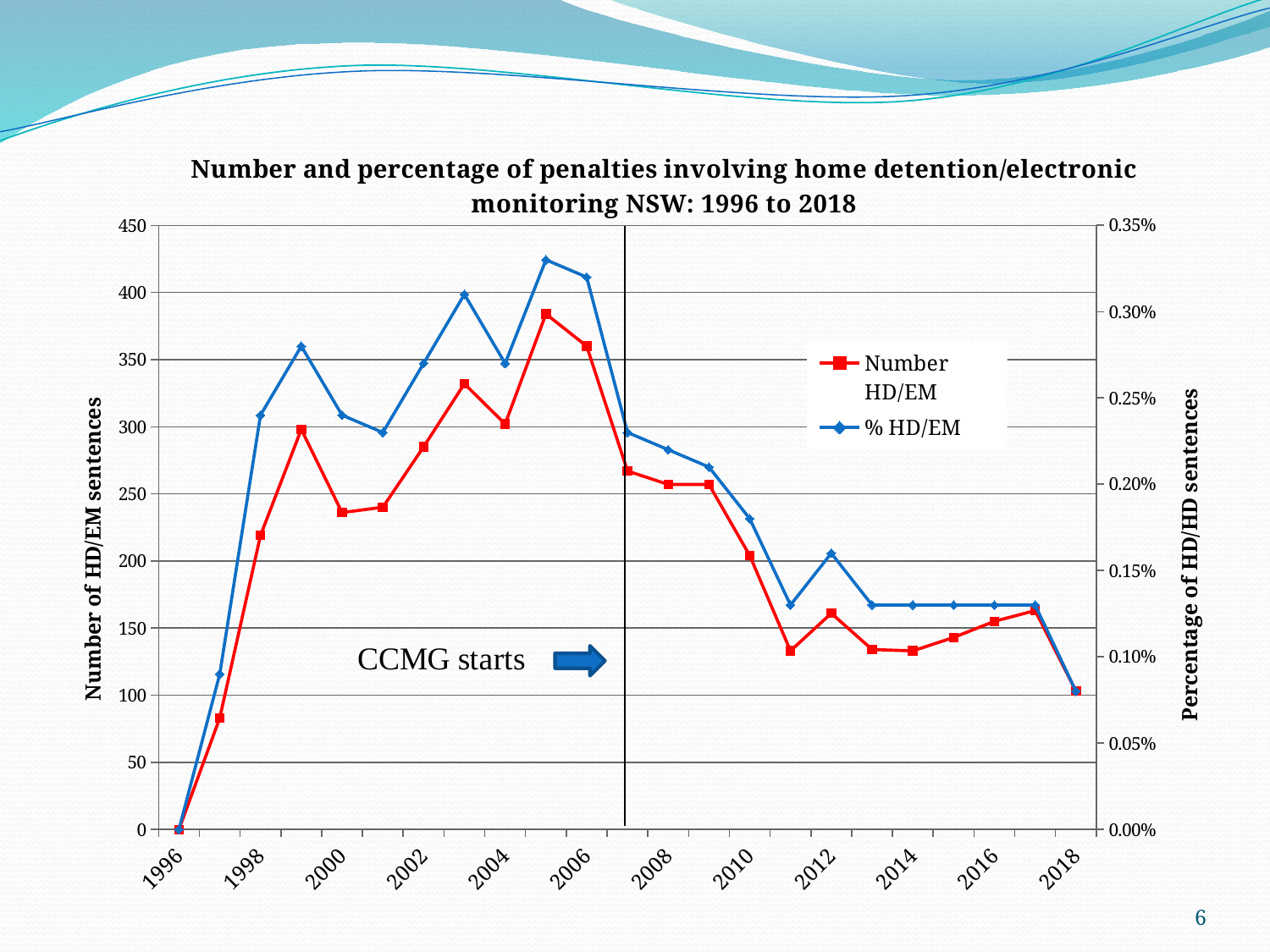
What kind of chart is shown on the slide? Line chart Does the Number HD/EM series rise or fall between 2006 and 2011? Fall What are the two series named in the legend? Number HD/EM and % HD/EM Is the Number HD/EM value for 2018 greater or less than 150? less Which year has the larger Number HD/EM value, 1999 or 2000? 1999 How many series does the legend list? 2 In which year is the Number HD/EM series at its lowest value? 1996 What annotation is written next to the vertical line on the chart? CCMG starts Is the Number HD/EM value for 2005 greater or less than 350? greater Is the % HD/EM value for 2005 greater or less than 0.30%? greater In which year does the Number HD/EM series reach its highest value? 2005